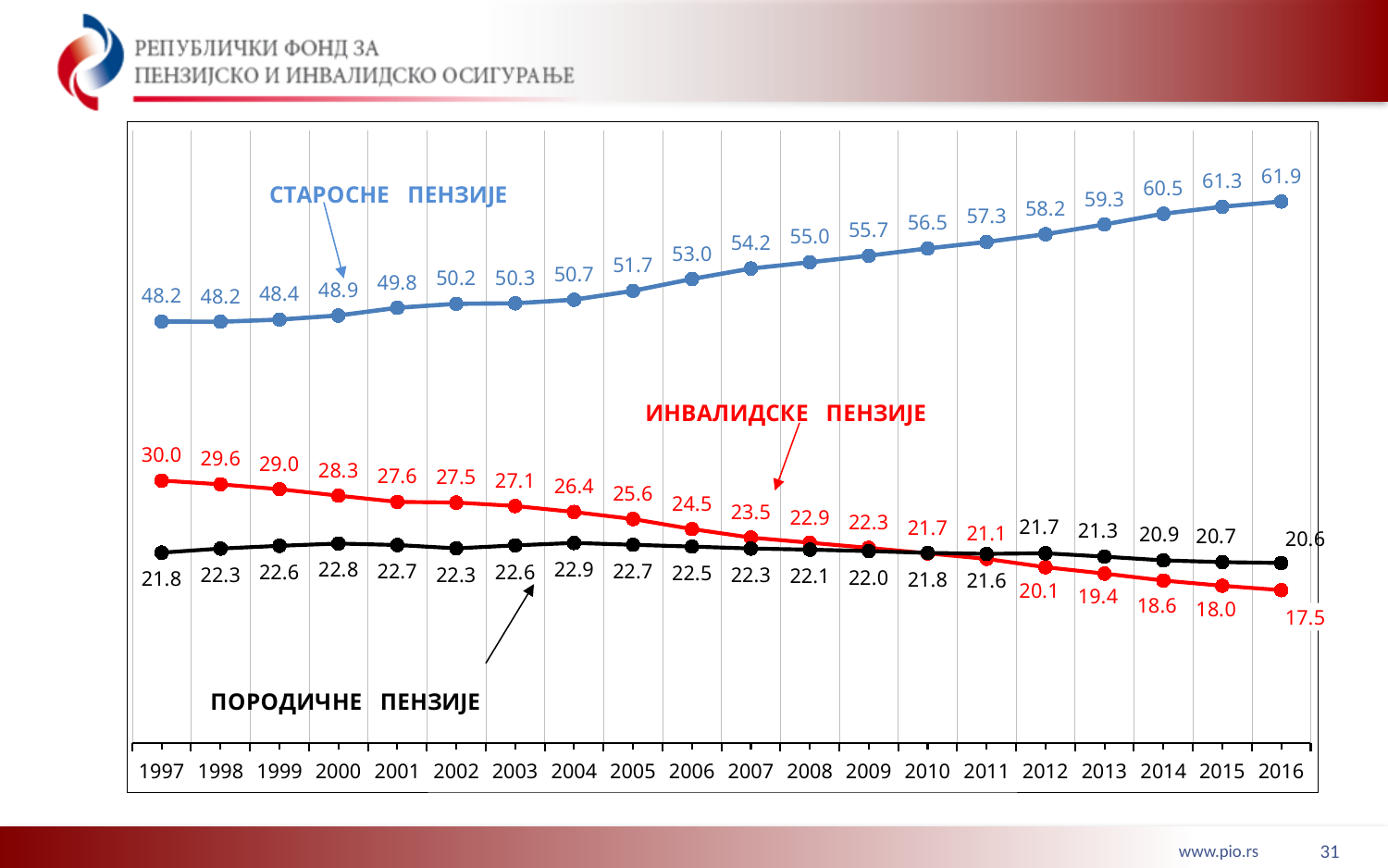
In which year is the value for СТАРОСНЕ ПЕНЗИЈЕ highest? 2016 What is the value for ПОРОДИЧНЕ ПЕНЗИЈЕ in 2004? 22.9 In which year is the value for ИНВАЛИДСКЕ ПЕНЗИЈЕ lowest? 2016 How many series are plotted on the chart? 3 How many years are shown on the x axis? 20 What type of chart is shown on the slide? Line chart What is the value for ИНВАЛИДСКЕ ПЕНЗИЈЕ in 1997? 30.0 What is the difference between the СТАРОСНЕ ПЕНЗИЈЕ values in 2016 and 1997? 13.7 What is the difference between the ИНВАЛИДСКЕ ПЕНЗИЈЕ values in 1997 and 2016? 12.5 Which is larger in 2016: ПОРОДИЧНЕ ПЕНЗИЈЕ or ИНВАЛИДСКЕ ПЕНЗИЈЕ? ПОРОДИЧНЕ ПЕНЗИЈЕ What is the value for СТАРОСНЕ ПЕНЗИЈЕ in 2016? 61.9 Does the value for ИНВАЛИДСКЕ ПЕНЗИЈЕ rise or fall from 1997 to 2016? Fall